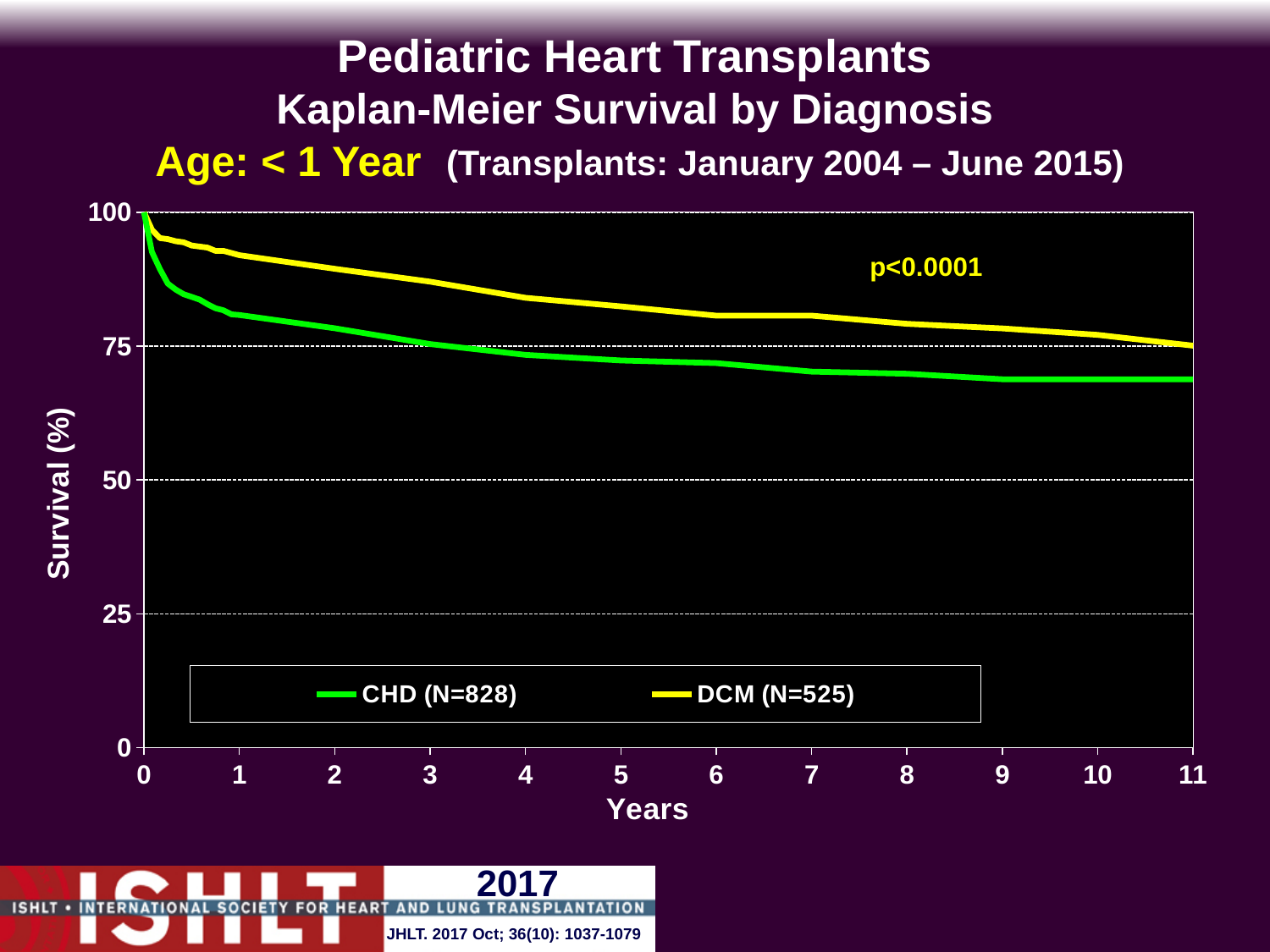
What kind of chart is shown on the slide? line chart What is the highest year shown on the x axis? 11 What is the number of patients (N) in the CHD group according to the legend? 828 What is the survival value for both series at year 0? 100 How many series does the legend list? 2 Is the survival value for DCM at year 2 greater or less than 100? less Is the survival value for CHD at year 1 greater or less than 75? greater Do the survival curves rise or fall as years increase? fall Is the survival value for CHD at year 10 greater or less than 75? less What p-value is shown on the chart? p<0.0001 Which series has the higher survival at year 5, CHD or DCM? DCM